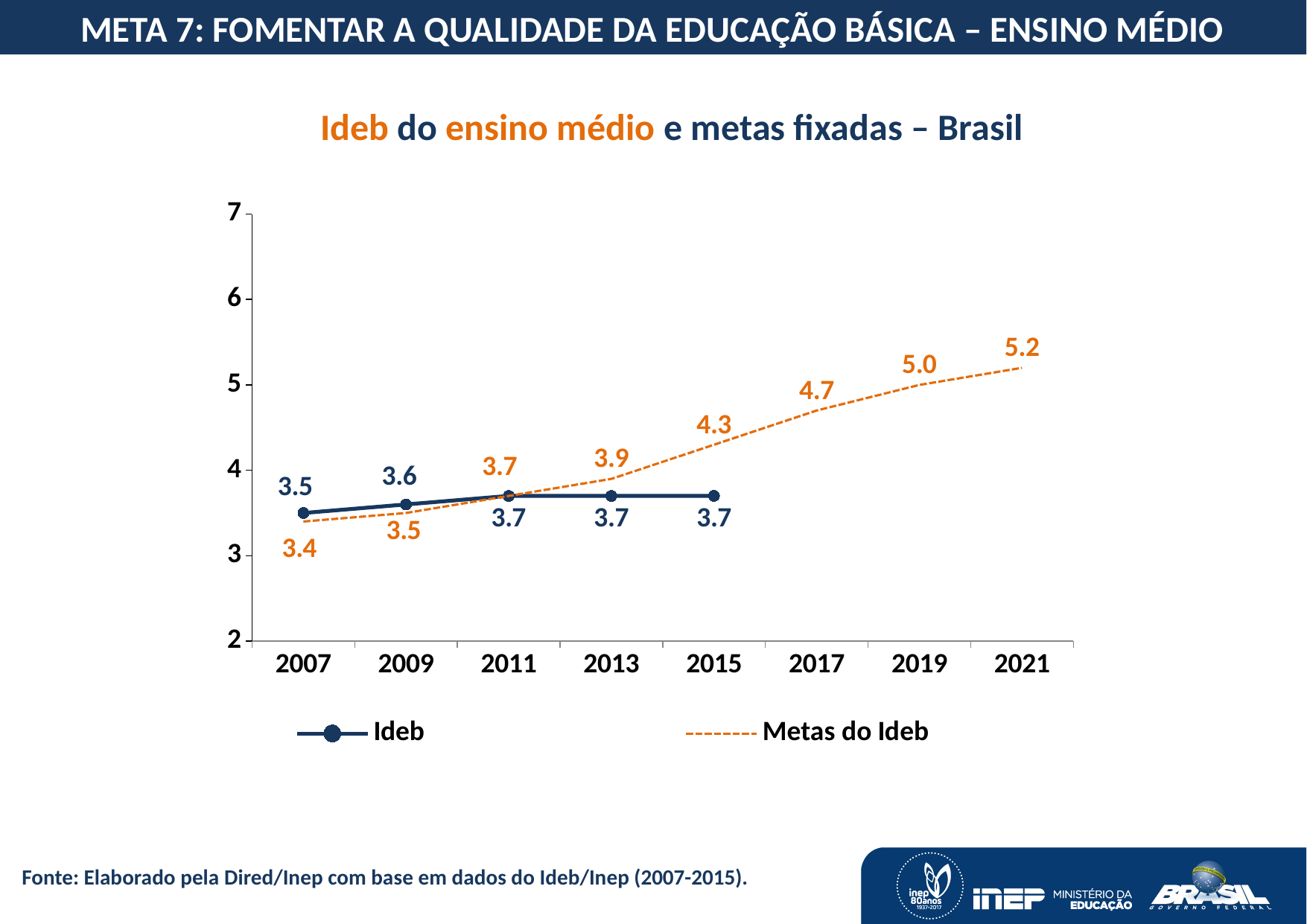
What is the Metas do Ideb value for 2015? 4.3 In which year is the Metas do Ideb value highest? 2021 What kind of chart is shown on the slide? Line chart Which is larger in 2009, the Ideb value or the Metas do Ideb value? Ideb What is the difference between the Metas do Ideb value and the Ideb value in 2015? 0.6 How many series does the legend list? 2 What is the Ideb value for 2015? 3.7 What is the Ideb value for 2007? 3.5 How many years are shown on the x axis? 8 In which year is the Metas do Ideb value lowest? 2007 Does the Metas do Ideb series rise or fall from 2007 to 2021? Rise What is the Metas do Ideb value for 2021? 5.2